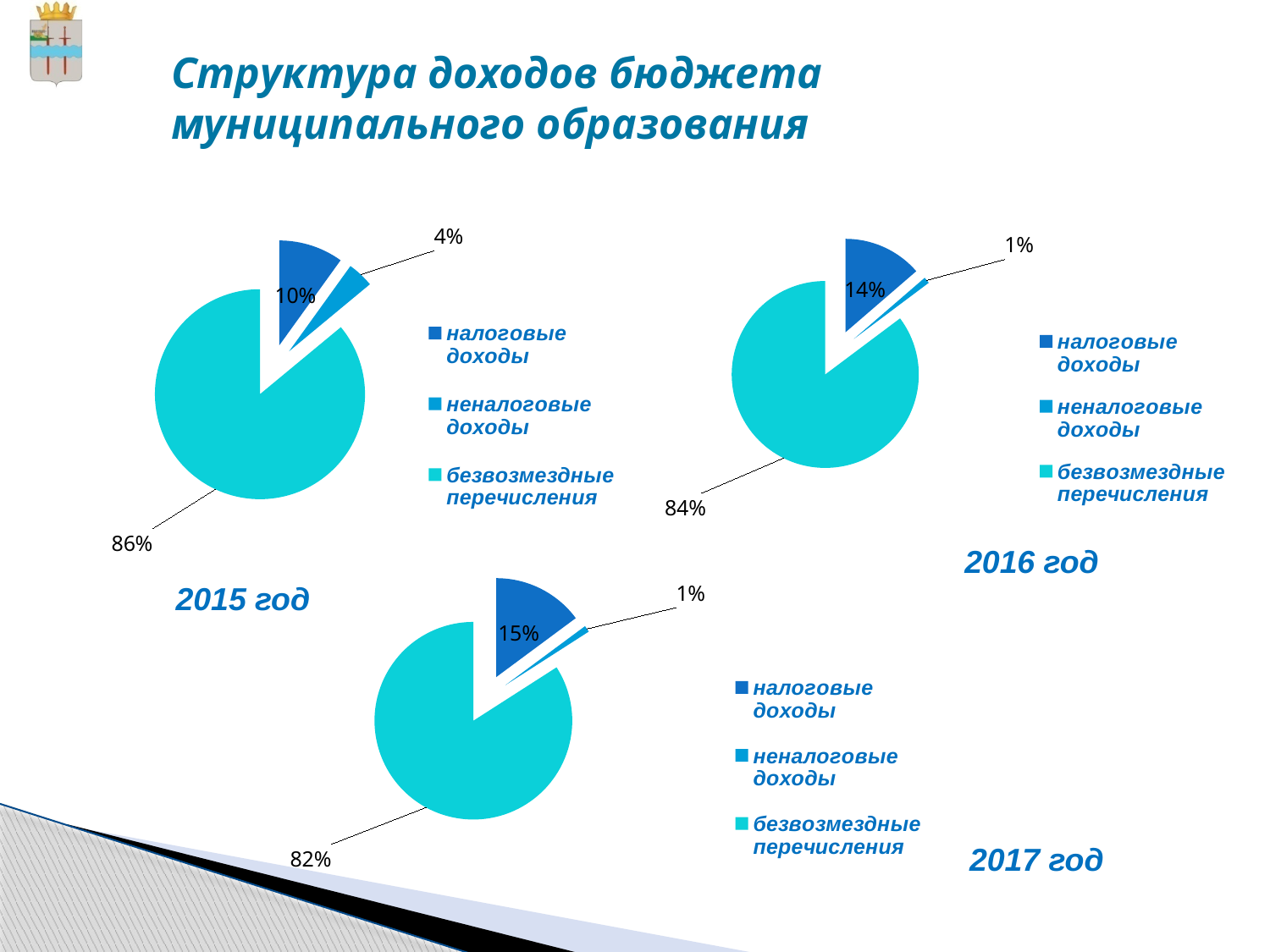
What type of chart is used for the 2015 год data? pie chart How many pie charts are shown on the slide? 3 In the 2015 год pie chart, which category has the smallest slice? неналоговые доходы In the 2015 год pie chart, what share is labelled for неналоговые доходы? 4% In the 2015 год pie chart, what share is labelled for безвозмездные перечисления? 86% In the 2017 год pie chart, which category has the largest slice? безвозмездные перечисления How many entries does the legend of the 2017 год chart list? 3 In the 2015 год pie chart, what is the difference between the shares of налоговые доходы and неналоговые доходы? 6% In the 2016 год pie chart, what share is labelled for налоговые доходы? 14% In the 2017 год pie chart, what share is labelled for безвозмездные перечисления? 82% Which is larger: the share of налоговые доходы in the 2016 год chart or in the 2017 год chart? 2017 год How many slices does the 2016 год pie chart have? 3